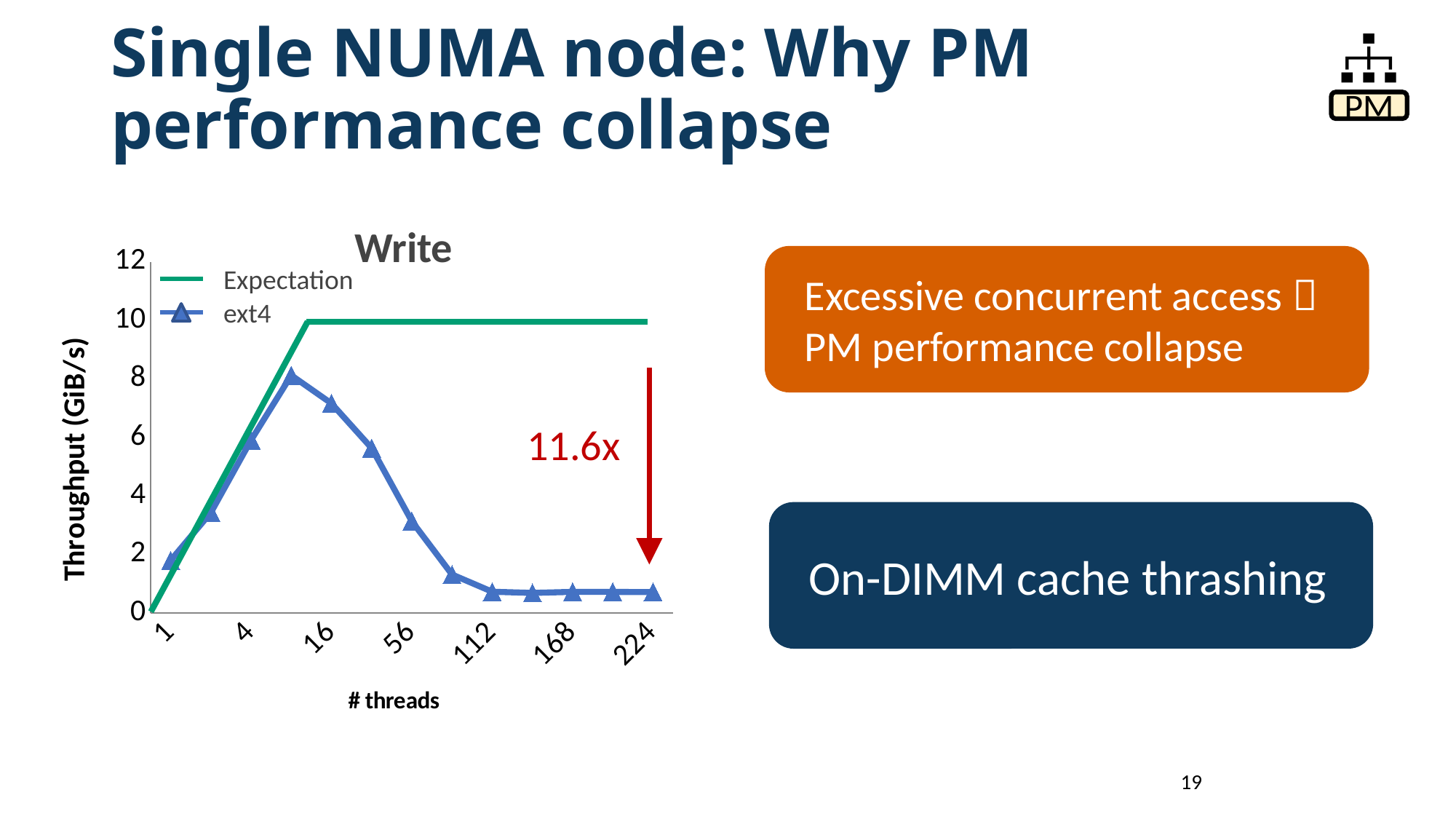
How many tick labels are shown on the x axis of the chart? 7 What kind of chart is shown on the slide? line chart What factor is printed next to the red arrow on the chart? 11.6x Is the ext4 throughput at 224 threads greater or less than 2 GiB/s? less Does the Expectation line rise or fall as the number of threads increases from 1 to 16? rise Is the Expectation throughput at 224 threads greater or less than 8 GiB/s? greater Does the ext4 throughput rise or fall as the number of threads increases from 16 to 224? fall Is the peak ext4 throughput greater or less than 10 GiB/s? less How many series does the legend of the chart list? 2 At 224 threads, which series has the higher throughput, Expectation or ext4? Expectation What is the title of the chart? Write